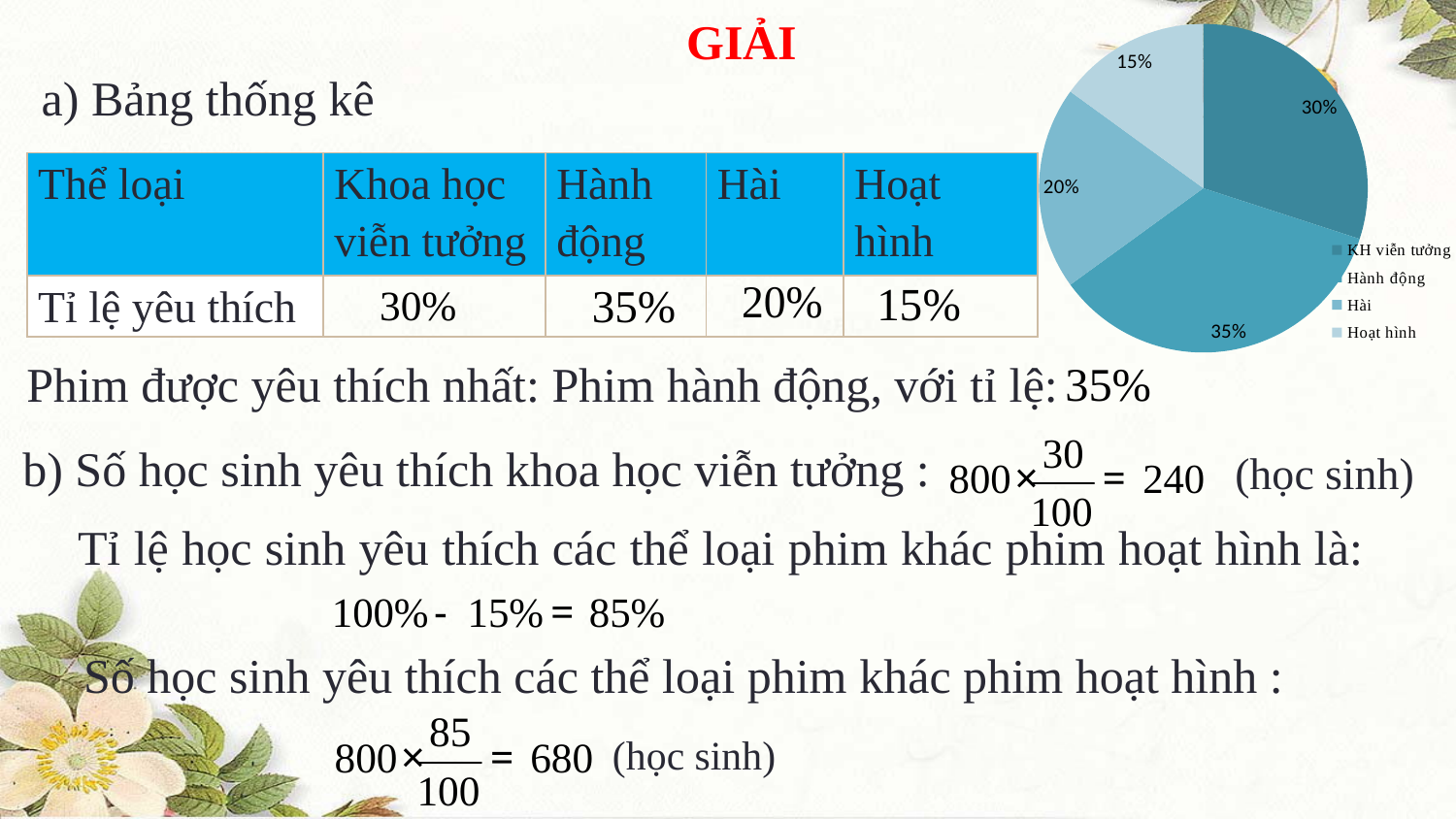
In the pie chart, which is larger: the share for KH viễn tưởng or the share for Hài? KH viễn tưởng In the pie chart, what share is shown for Hành động? 35% In the pie chart, what is the difference between the shares for Hành động and Hoạt hình? 20% How many entries does the pie chart's legend list? 4 In the pie chart, what share is shown for Hài? 20% In the pie chart, what share is shown for KH viễn tưởng? 30% Which category has the largest slice in the pie chart? Hành động What kind of chart is shown on the slide? pie chart How many slices does the pie chart have? 4 Which category has the smallest slice in the pie chart? Hoạt hình What is the first entry listed in the pie chart's legend? KH viễn tưởng In the pie chart, what share is shown for Hoạt hình? 15%